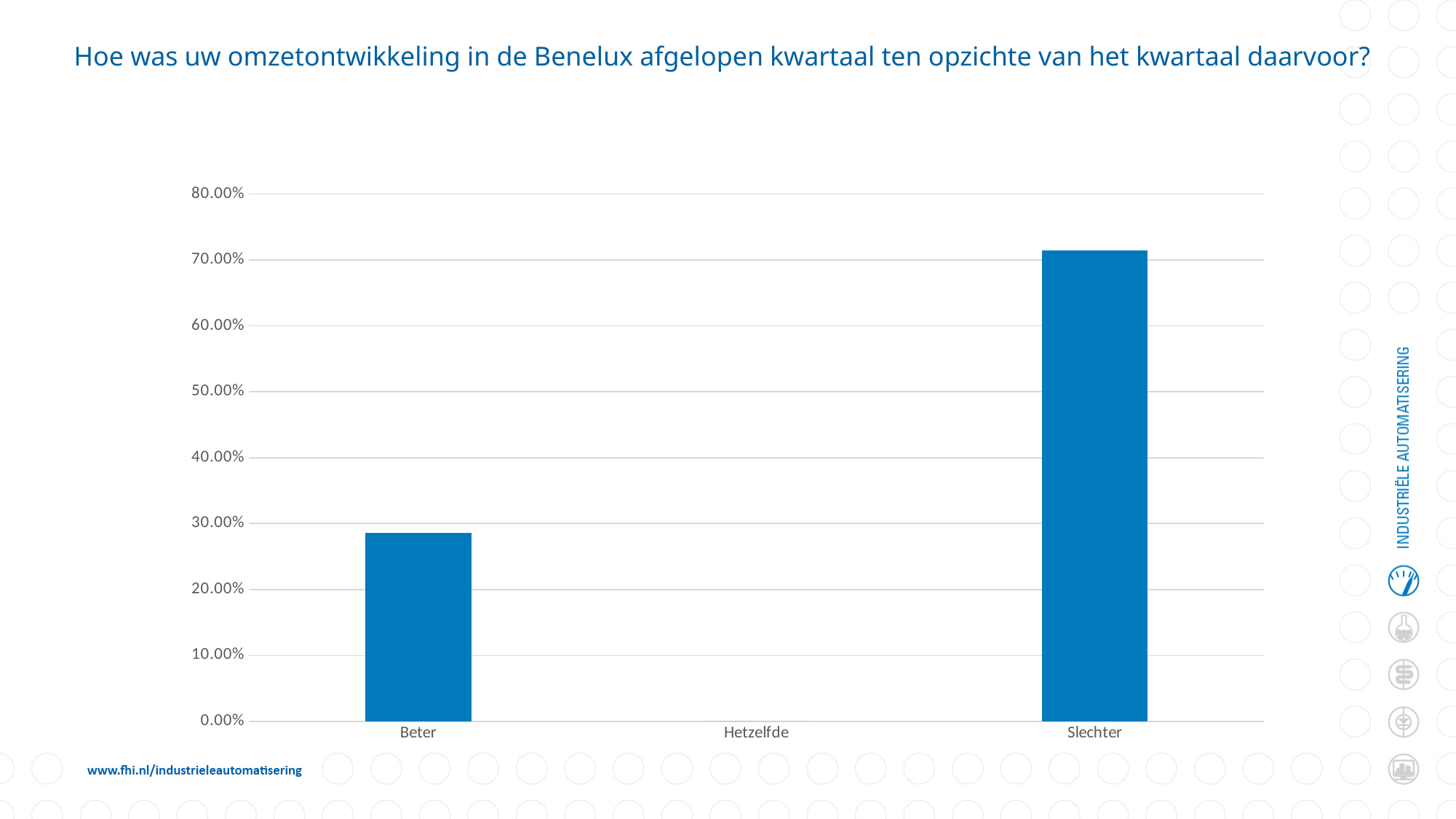
What colour are the bars in the chart? blue Which category has the highest value in the chart? Slechter Which is larger, the value for Beter or the value for Slechter? Slechter Is the value for Beter greater or less than 30.00%? less Which category has the lowest value in the chart? Hetzelfde What is the title of the chart on the slide? Hoe was uw omzetontwikkeling in de Benelux afgelopen kwartaal ten opzichte van het kwartaal daarvoor? Is the value for Hetzelfde greater or less than 10.00%? less Is the value for Slechter greater or less than 80.00%? less What kind of chart is shown on the slide? bar chart How many categories are shown on the x axis of the chart? 3